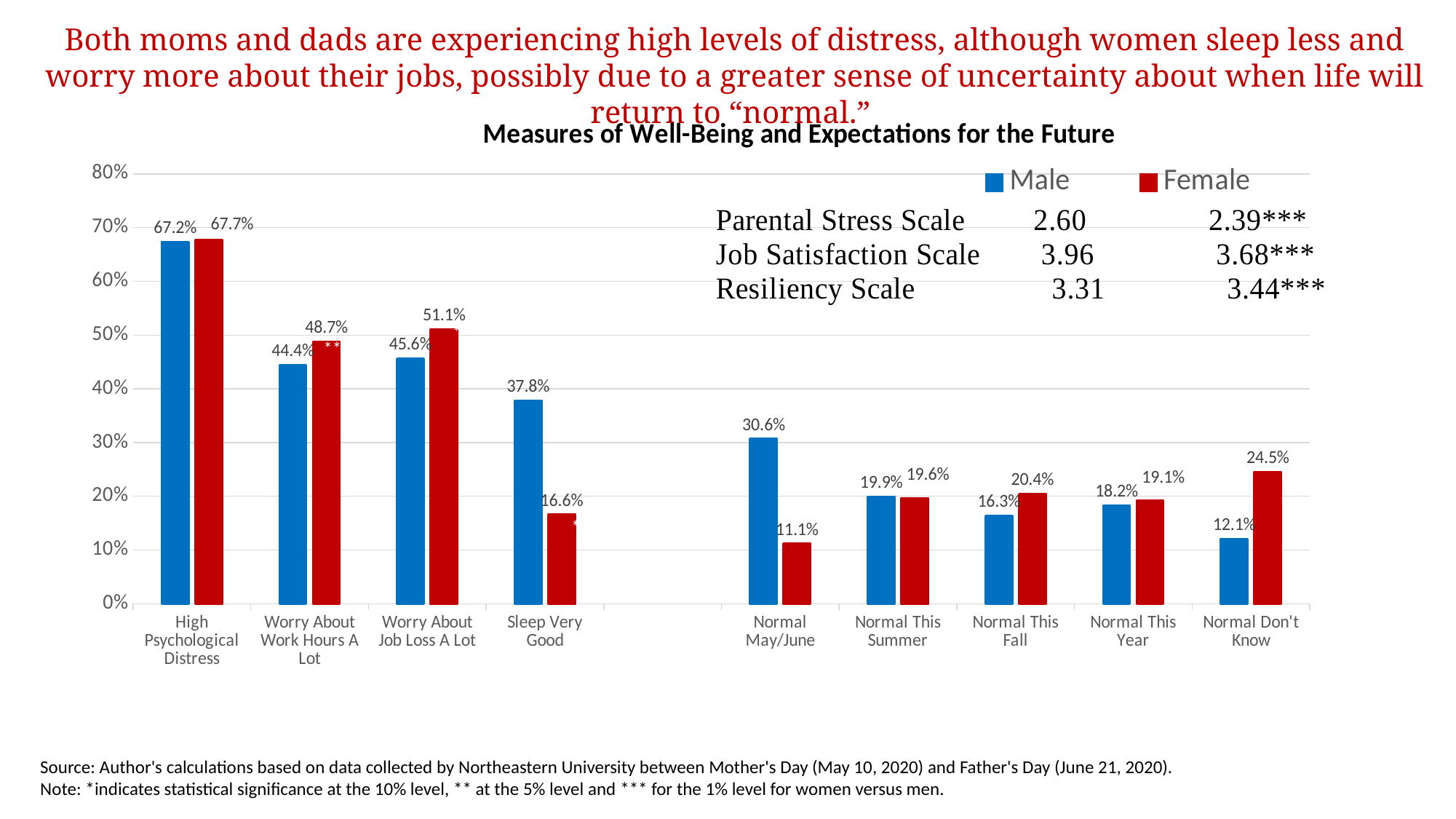
Is the Male value for Worry About Work Hours A Lot greater or less than 50%? less What is the Female value for Normal Don't Know? 24.5% Which is larger for Normal Don't Know, the Male value or the Female value? Female What kind of chart is shown on the slide? Bar chart How many series does the legend list? 2 What is the title of the chart? Measures of Well-Being and Expectations for the Future Which category has the highest Female value? High Psychological Distress What is the difference between the Male and Female values for Sleep Very Good? 21.2% What is the Male value for Sleep Very Good? 37.8% What is the Male value for Normal May/June? 30.6% What is the Female value for Worry About Job Loss A Lot? 51.1% Which category has the lowest Female value? Normal May/June